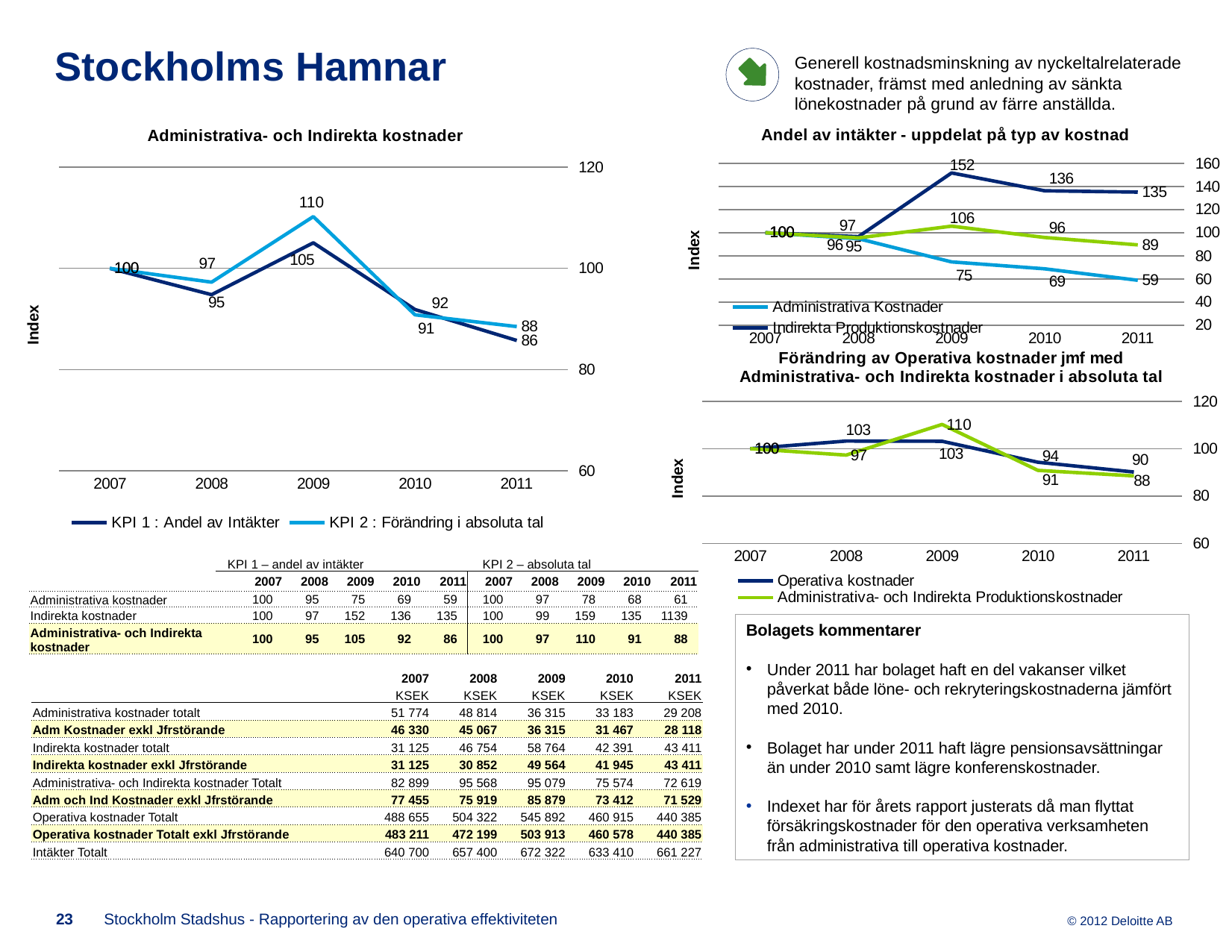
In the chart titled 'Andel av intäkter - uppdelat på typ av kostnad', which series has the larger value in 2011, Administrativa Kostnader or Indirekta Produktionskostnader? Indirekta Produktionskostnader In the chart titled 'Andel av intäkter - uppdelat på typ av kostnad', in which year is Administrativa Kostnader lowest? 2011 In the chart titled 'Administrativa- och Indirekta kostnader', how many series does the legend list? 2 What kind of chart is the one titled 'Förändring av Operativa kostnader jmf med Administrativa- och Indirekta kostnader i absoluta tal'? line chart In the chart titled 'Andel av intäkter - uppdelat på typ av kostnad', what is the value of Indirekta Produktionskostnader in 2009? 152 In the chart titled 'Administrativa- och Indirekta kostnader', what is the value of KPI 2 : Förändring i absoluta tal in 2011? 88 In the chart titled 'Förändring av Operativa kostnader jmf med Administrativa- och Indirekta kostnader i absoluta tal', what is the difference between Operativa kostnader and Administrativa- och Indirekta Produktionskostnader in 2008? 6 In the chart titled 'Administrativa- och Indirekta kostnader', what is the difference between KPI 2 and KPI 1 in 2009? 5 In the chart titled 'Administrativa- och Indirekta kostnader', what is the value of KPI 1 : Andel av Intäkter in 2009? 105 In the chart titled 'Andel av intäkter - uppdelat på typ av kostnad', does Administrativa Kostnader rise or fall from 2007 to 2011? fall In the chart titled 'Förändring av Operativa kostnader jmf med Administrativa- och Indirekta kostnader i absoluta tal', what is the value of Operativa kostnader in 2010? 94 In the chart titled 'Administrativa- och Indirekta kostnader', in which year is KPI 2 : Förändring i absoluta tal highest? 2009